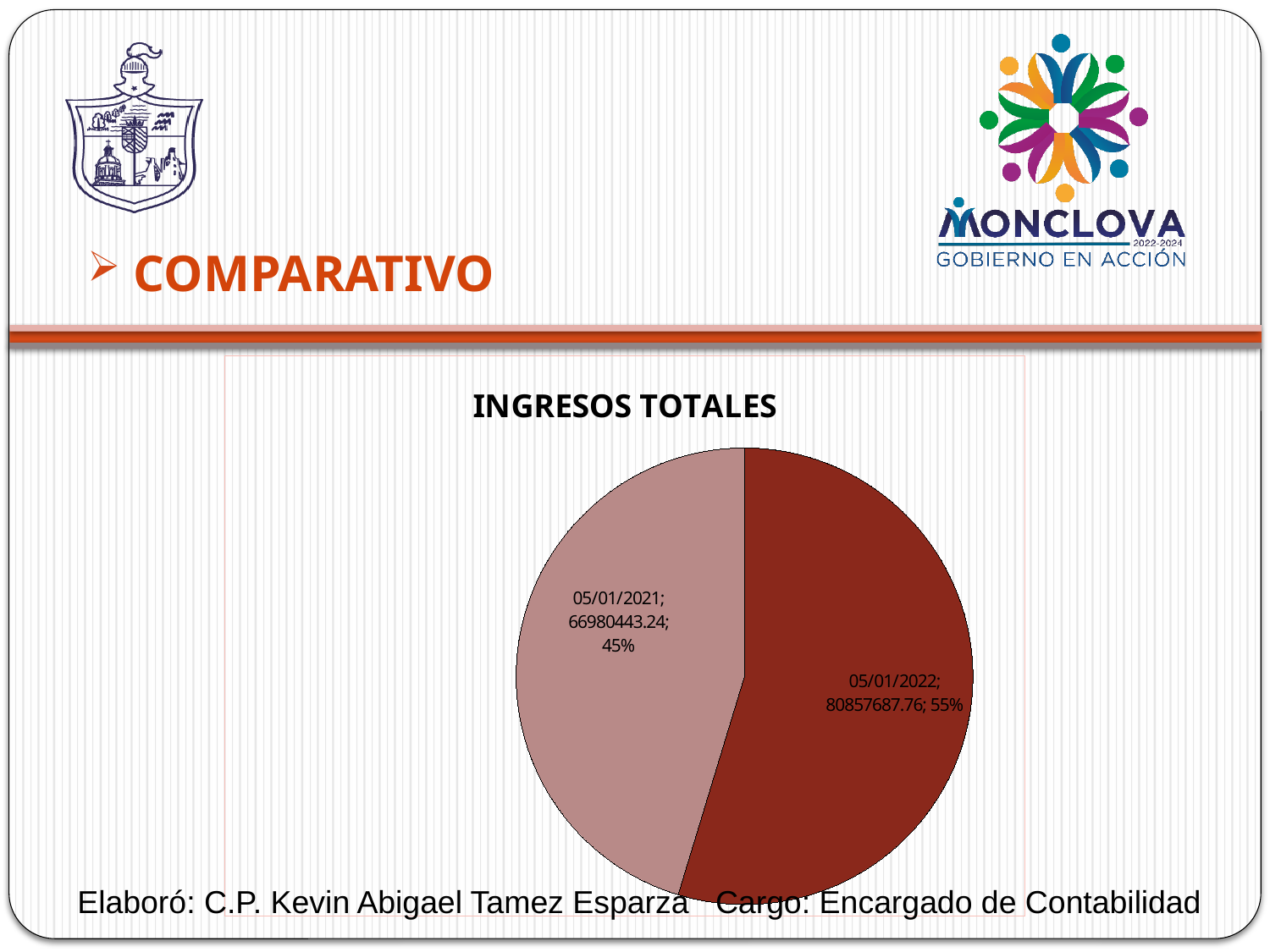
What share of the pie does 05/01/2022 represent? 55% How many slices does the pie chart have? 2 What is the title of the chart? INGRESOS TOTALES Which slice is the smallest? 05/01/2021 What is the value for 05/01/2021? 66980443.24 Which slice is the largest? 05/01/2022 What is the total of the two values shown in the pie chart? 147838131.00 What is the difference between the values for 05/01/2022 and 05/01/2021? 13877244.52 Which is larger, the value for 05/01/2021 or 05/01/2022? 05/01/2022 What share of the pie does 05/01/2021 represent? 45% What kind of chart is shown on the slide? pie chart What is the value for 05/01/2022? 80857687.76